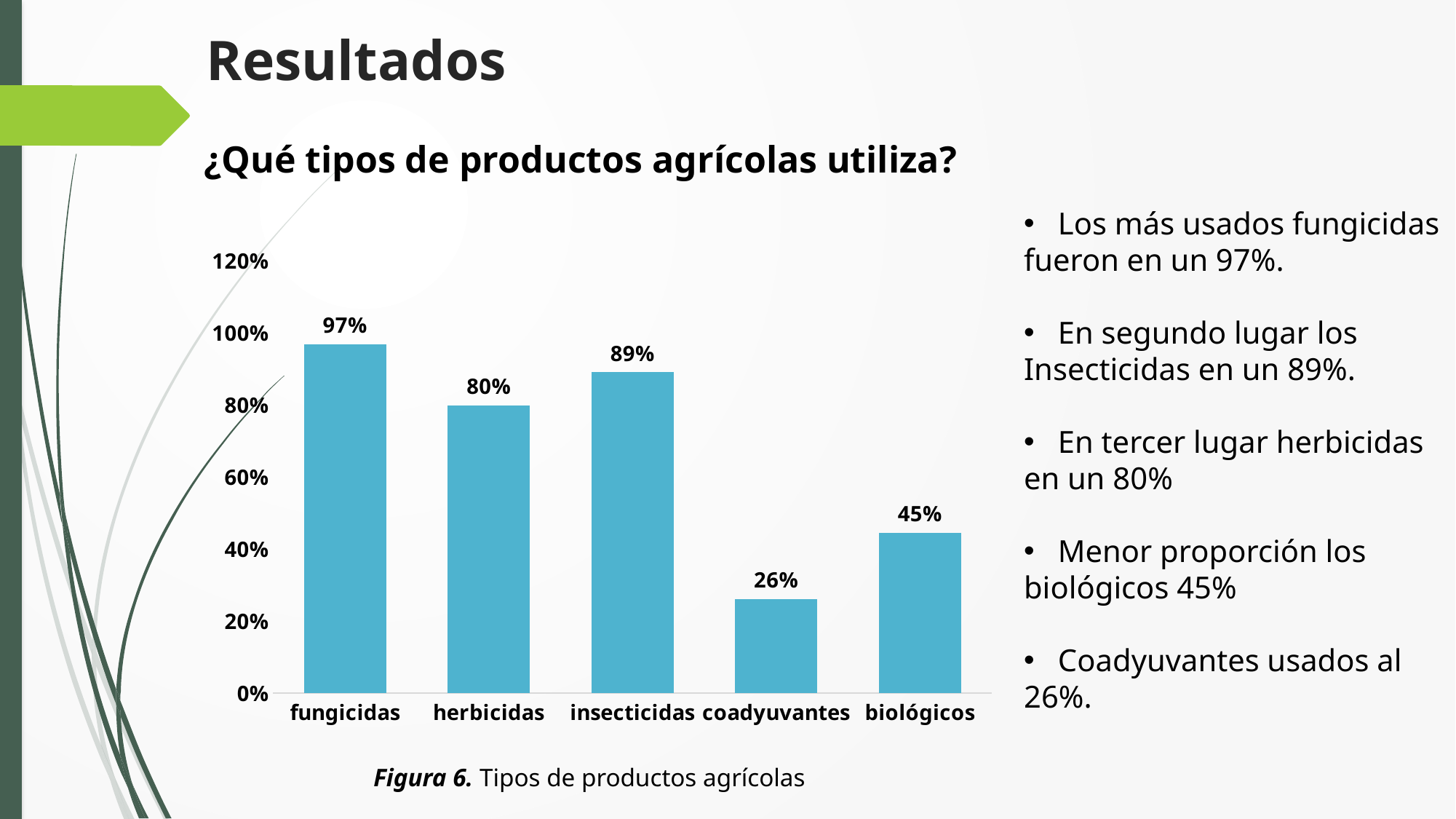
Which category has the lowest value? coadyuvantes Which category has the highest value? fungicidas How many categories are shown on the x axis? 5 What is the value for coadyuvantes? 26% What is the difference between the values for biológicos and coadyuvantes? 19% What kind of chart is shown on the slide? bar chart What is the figure caption below the chart? Figura 6. Tipos de productos agrícolas What is the difference between the values for fungicidas and herbicidas? 17% Is the value for biológicos greater or less than 40%? greater What is the value for biológicos? 45% Which is larger, the value for herbicidas or the value for insecticidas? insecticidas What is the value for fungicidas? 97%